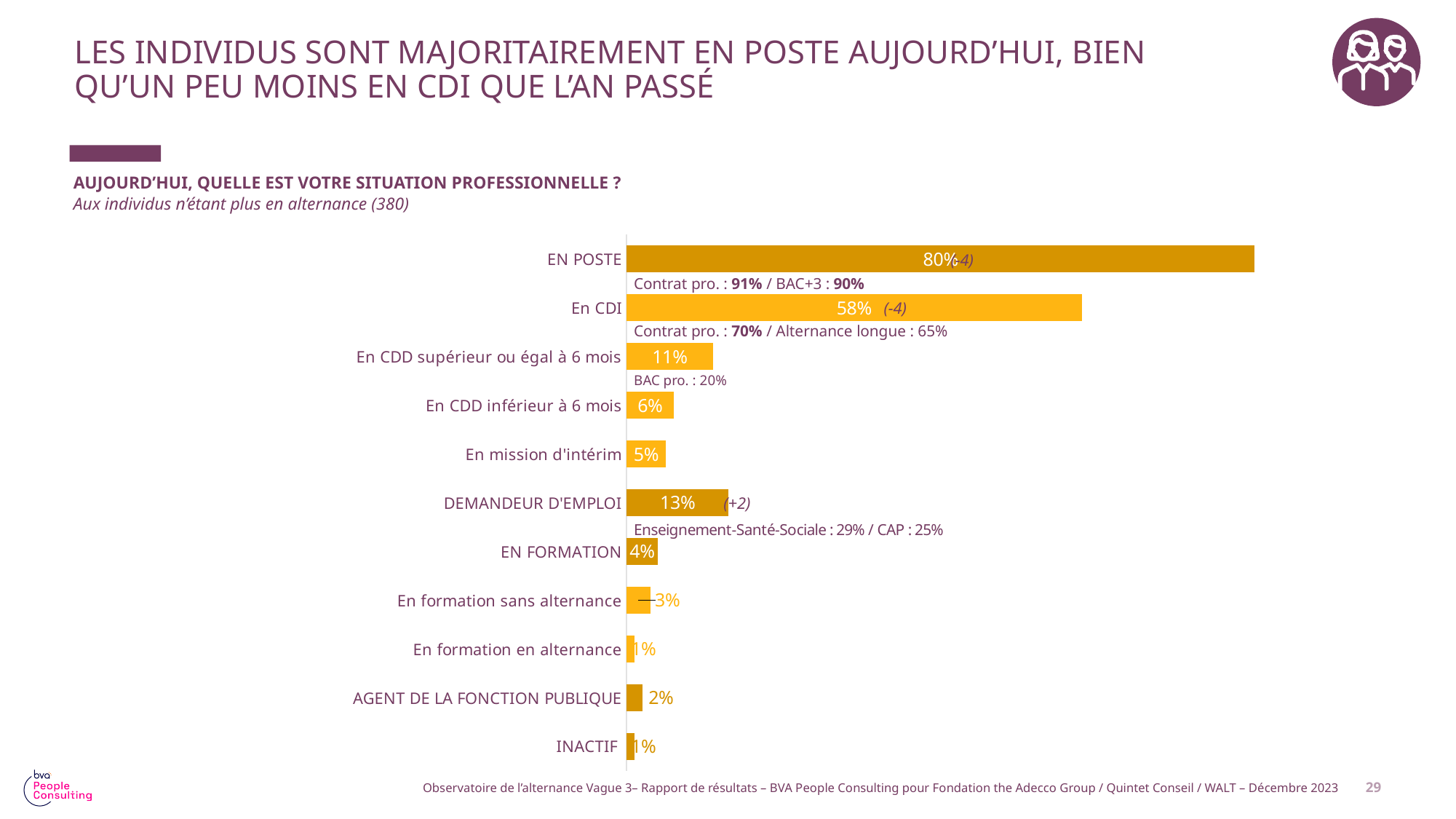
What is the value for EN POSTE? 80% What is the value for DEMANDEUR D'EMPLOI? 13% Which category has the highest value? EN POSTE What kind of chart is shown on the slide? Bar chart Which is larger, the value for DEMANDEUR D'EMPLOI or the value for En CDD supérieur ou égal à 6 mois? DEMANDEUR D'EMPLOI What is the value for En CDD supérieur ou égal à 6 mois? 11% What is the value for AGENT DE LA FONCTION PUBLIQUE? 2% What is the value for En CDI? 58% What is the difference between the values for EN POSTE and En CDI? 22 points What change from the previous year is shown next to the En CDI bar? (-4) What is the value for En mission d'intérim? 5% How many categories are shown in the chart? 11